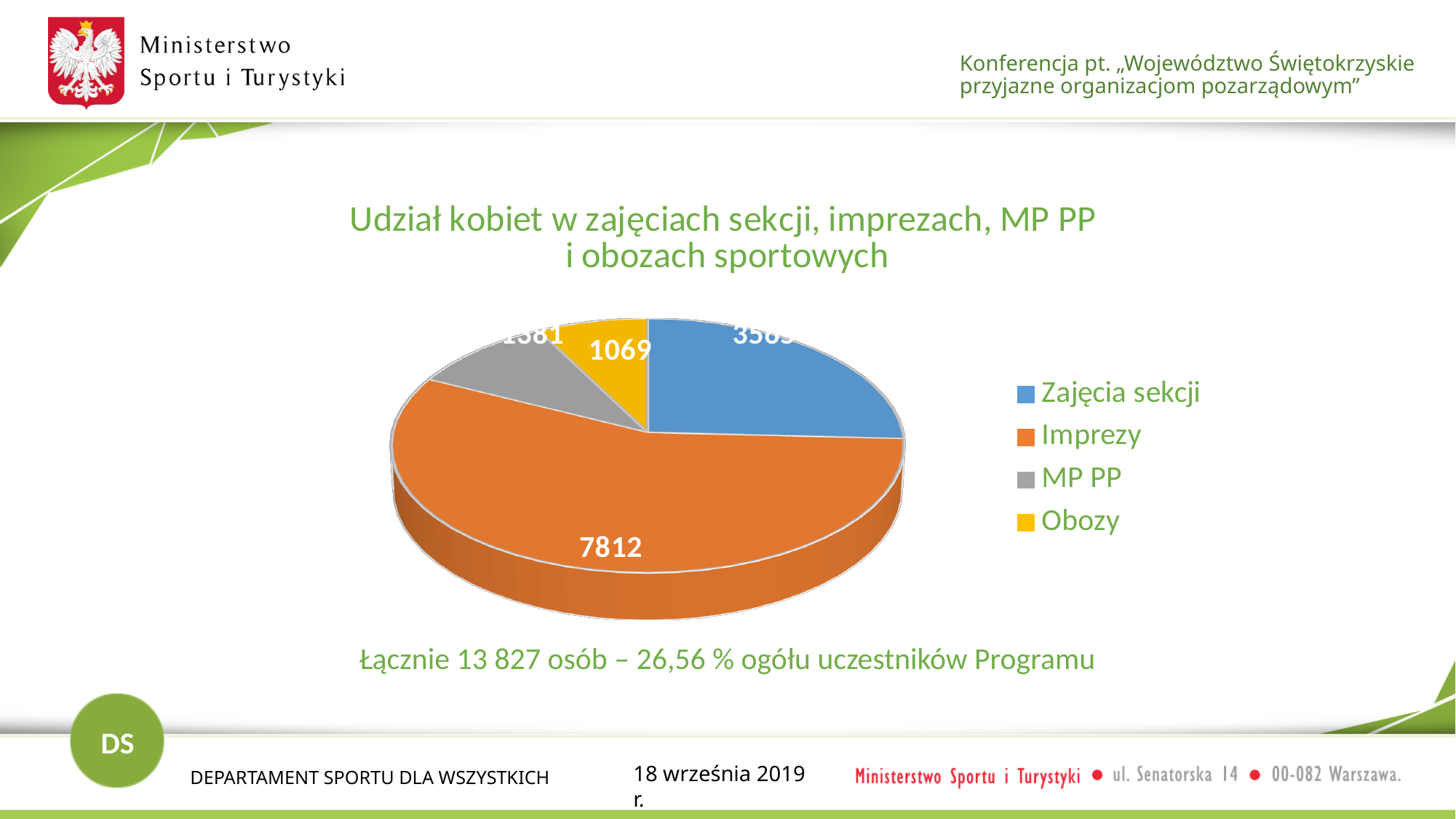
Which slice is larger, Imprezy or Zajęcia sekcji? Imprezy What is the value shown for the Imprezy slice in the pie chart? 7812 According to the text below the chart, what is the total number of people represented? 13 827 osób Which category has the largest slice in the pie chart? Imprezy What is the title of the chart on the slide? Udział kobiet w zajęciach sekcji, imprezach, MP PP i obozach sportowych Which slice is larger, Zajęcia sekcji or Obozy? Zajęcia sekcji How many categories are shown in the pie chart? 4 What type of chart is shown on the slide? Pie chart What colour is the Imprezy slice in the pie chart? Orange What is the value shown for the Obozy slice in the pie chart? 1069 What is the difference between the Imprezy value and the Obozy value? 6743